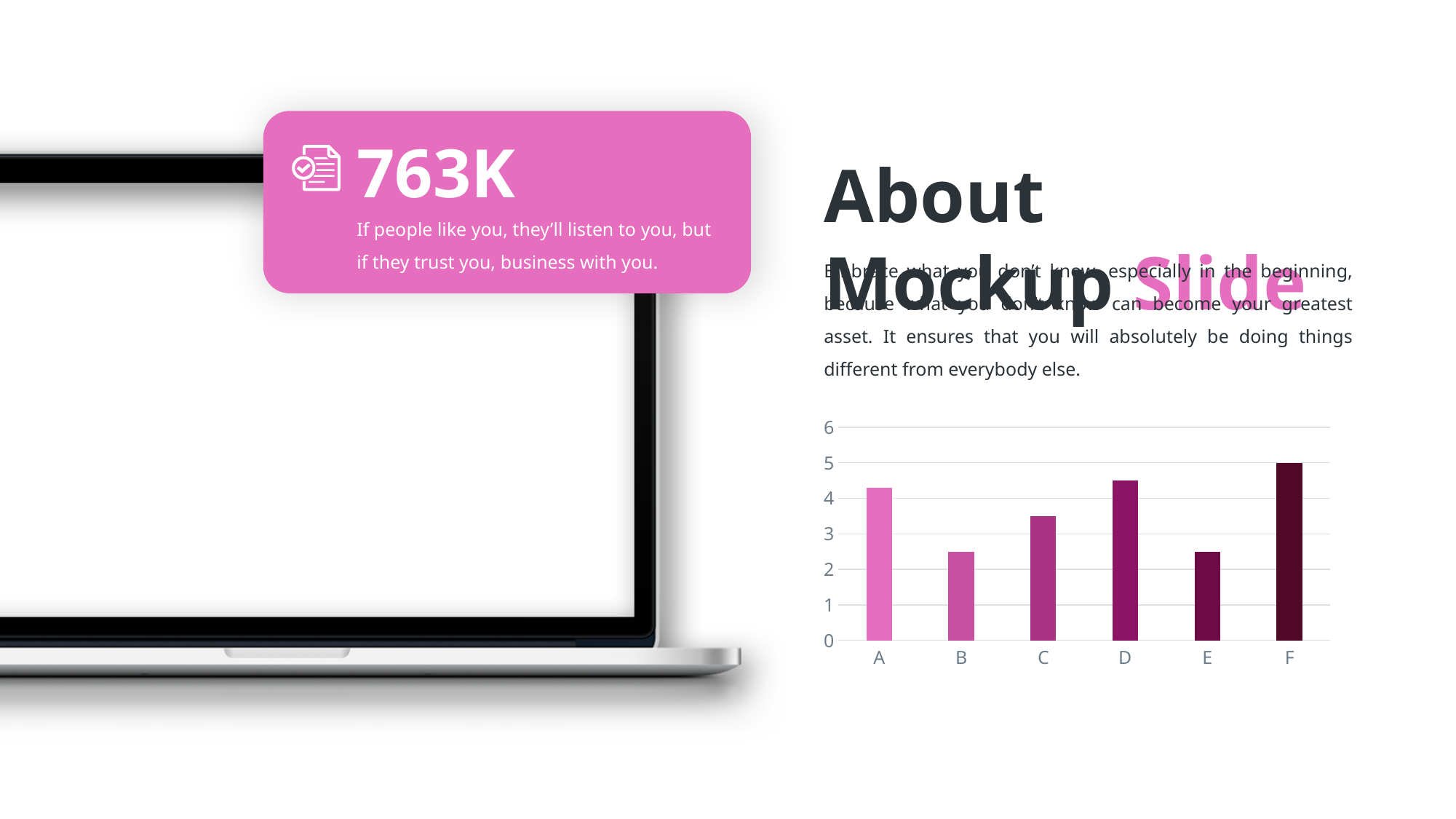
How many categories are shown on the x axis of the bar chart? 6 Is the value for E greater or less than 3? less Is the value for A greater or less than 4? greater Which is larger, the value for C or the value for D? D Is the value for B greater or less than 3? less What kind of chart is shown on the slide? bar chart Which category has the highest bar in the chart? F What is the value for category F in the bar chart? 5 Which is larger, the value for A or the value for B? A What is the highest value shown on the y axis of the chart? 6